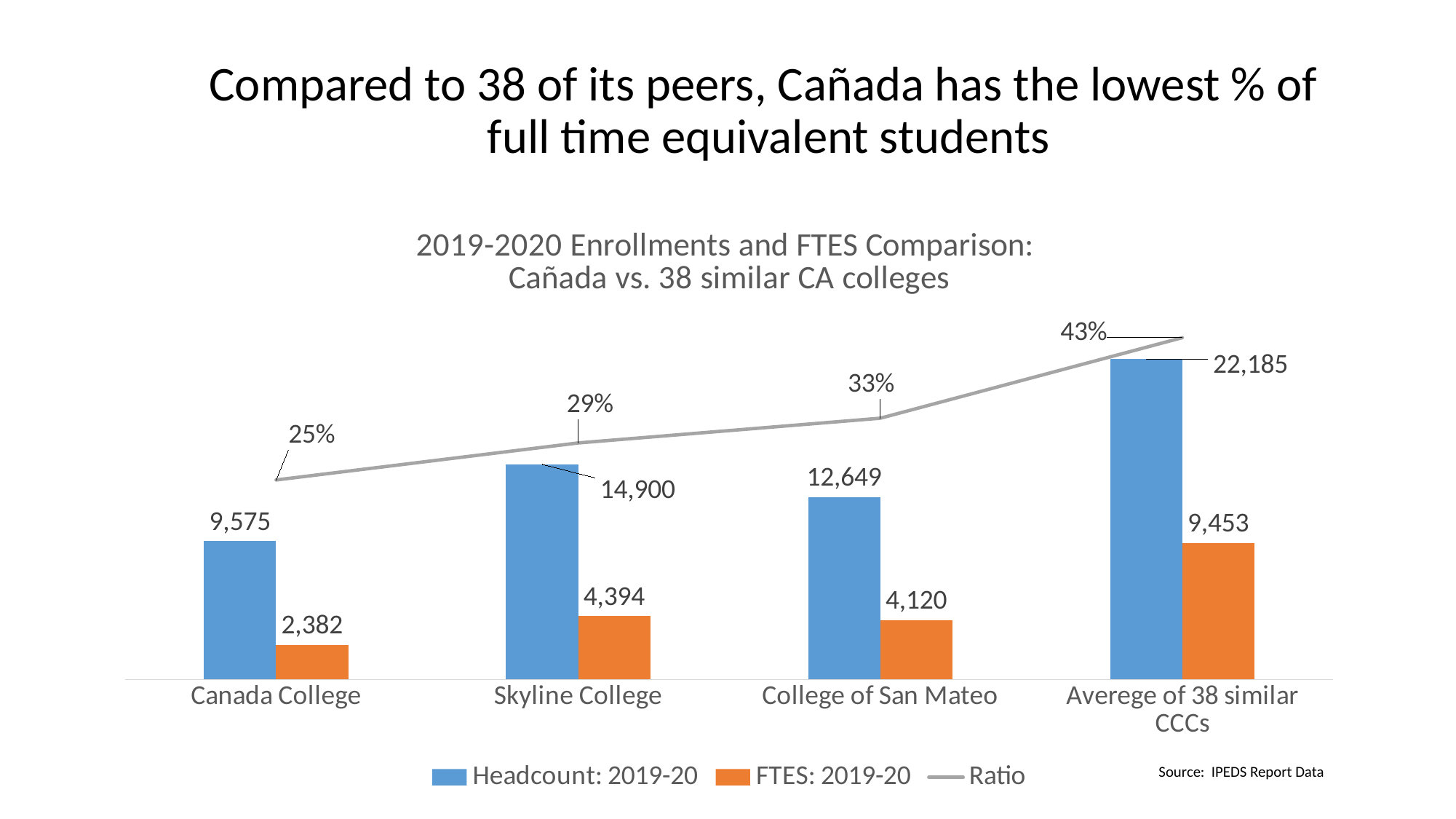
Which category has the highest Headcount: 2019-20 value? Averege of 38 similar CCCs What is the Headcount: 2019-20 value for Canada College? 9,575 What is the title of the chart? 2019-2020 Enrollments and FTES Comparison: Cañada vs. 38 similar CA colleges What is the FTES: 2019-20 value for the Averege of 38 similar CCCs? 9,453 What is the Ratio value for College of San Mateo? 33% Which is larger: the FTES: 2019-20 value for Skyline College or for College of San Mateo? Skyline College How many categories are shown on the x axis? 4 How many series does the legend list? 3 What is the FTES: 2019-20 value for Skyline College? 4,394 Which category has the lowest Ratio value? Canada College What is the difference between the Headcount: 2019-20 values for Skyline College and College of San Mateo? 2,251 Does the Ratio line rise or fall from left to right across the categories? rise